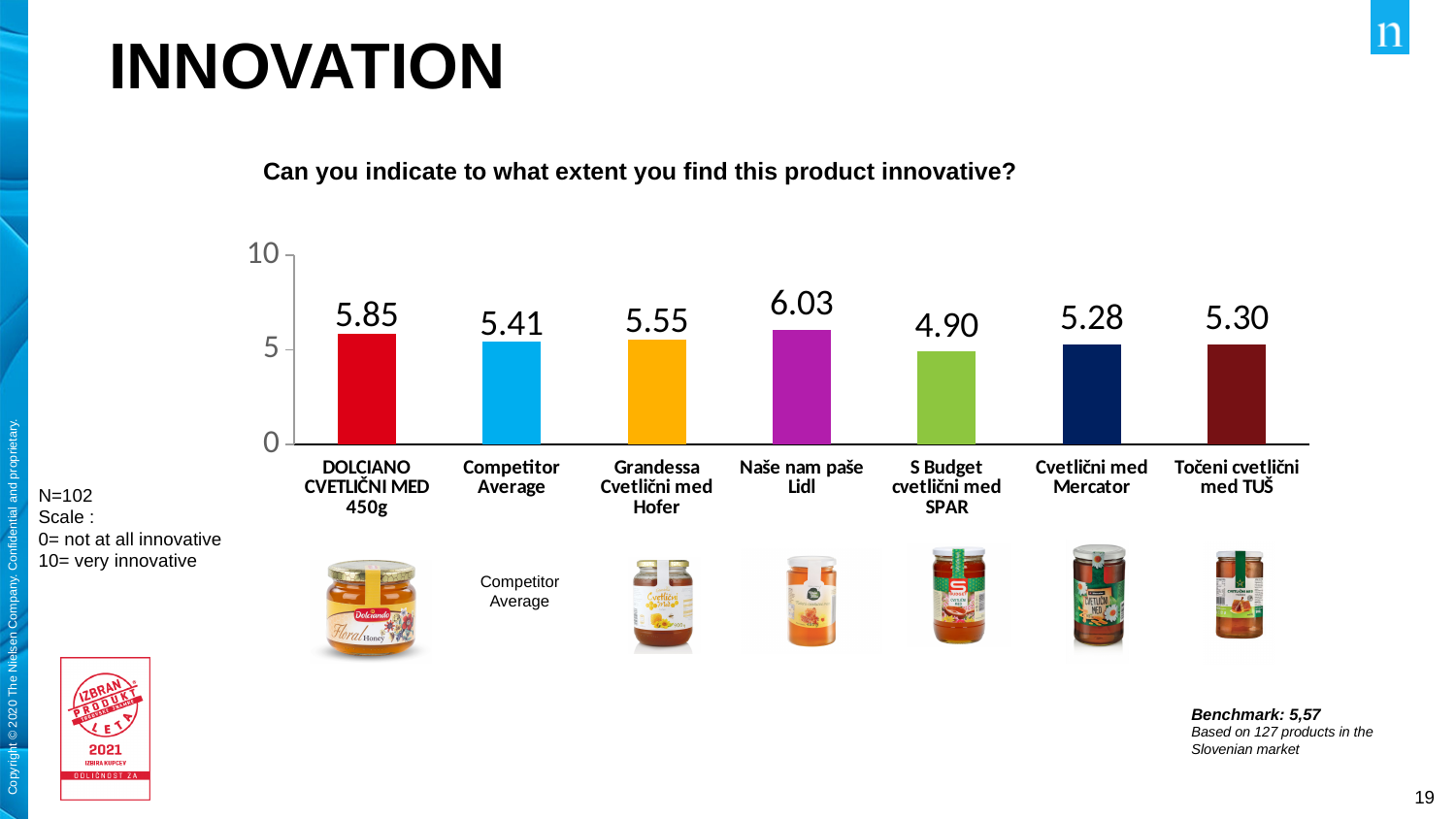
Which product has the lowest innovation score? S Budget cvetlični med SPAR Is the value for Cvetlični med Mercator greater or less than 5? greater What kind of chart is shown on the slide? Bar chart What is the value for S Budget cvetlični med SPAR? 4.90 What is the value for Naše nam paše Lidl? 6.03 Which product has the highest innovation score? Naše nam paše Lidl What is the value shown for Competitor Average? 5.41 How many bars are shown in the chart? 7 Which has a higher score, DOLCIANO CVETLIČNI MED 450g or Grandessa Cvetlični med Hofer? DOLCIANO CVETLIČNI MED 450g What is the difference between the scores of Naše nam paše Lidl and S Budget cvetlični med SPAR? 1.13 What is the benchmark value stated on the slide? 5,57 What is the innovation score for DOLCIANO CVETLIČNI MED 450g? 5.85